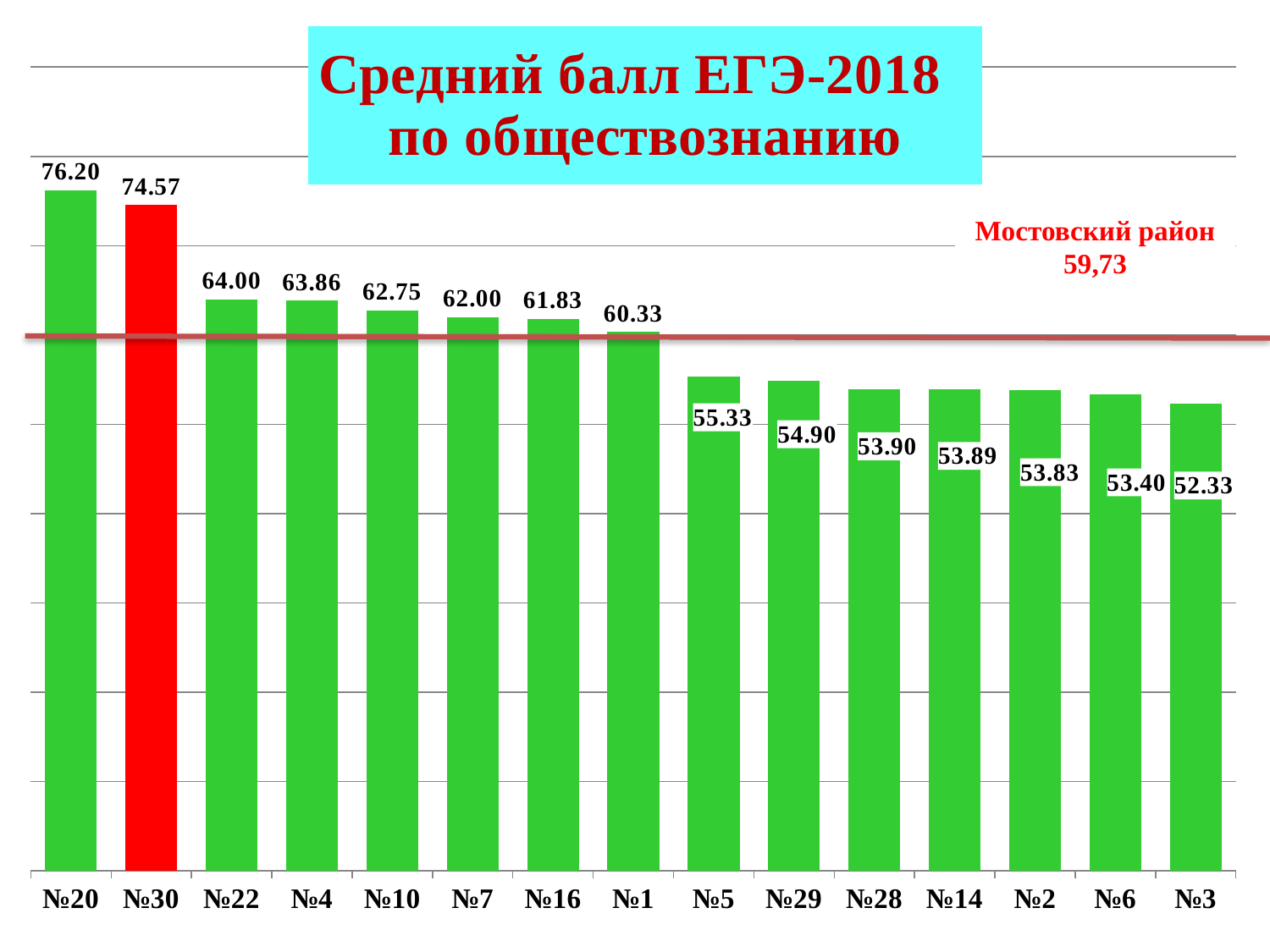
What is the difference between the values for №22 and №3? 11.67 Which category has the highest value? №20 Which category has the lowest value? №3 What is the value for №5? 55.33 Which is larger, the value for №10 or the value for №29? №10 What is the difference between the values for №20 and №30? 1.63 What value is shown for Мостовский район next to the horizontal line? 59,73 Do the values rise or fall from left to right along the x axis? fall What is the value for №16? 61.83 What kind of chart is this? bar chart How many categories are shown on the x axis? 15 What is the value for №30? 74.57